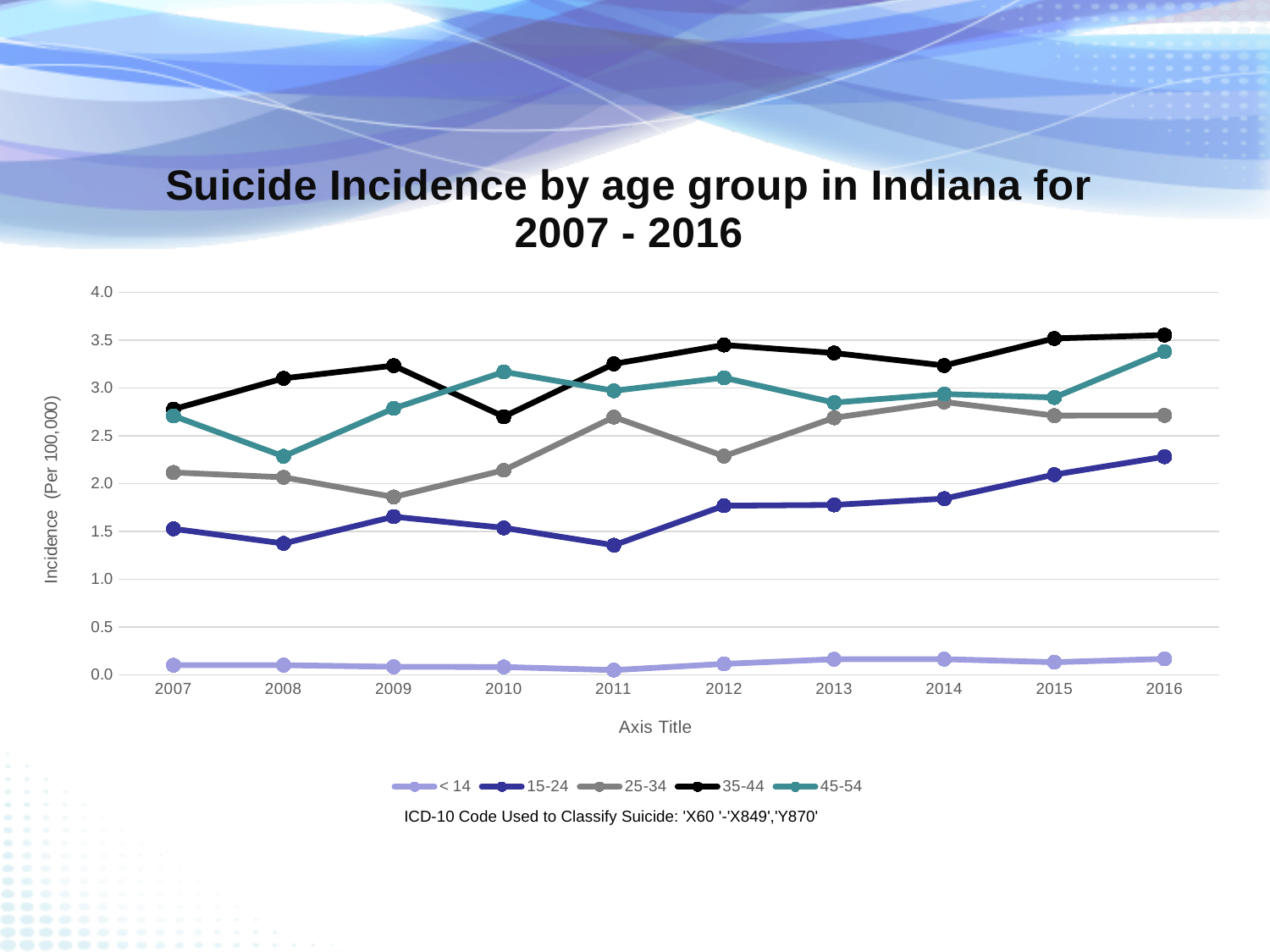
What is the label on the vertical axis? Incidence (Per 100,000) How many age-group series does the legend list? 5 Is the value for the 15-24 age group in 2011 greater or less than 1.5? less Which age group has the lowest values across all years shown? < 14 What is the title of the chart? Suicide Incidence by age group in Indiana for 2007 - 2016 Which age group has the highest value in 2016? 35-44 Is the value for the 25-34 age group in 2009 greater or less than 2.0? less What kind of chart is shown on the slide? line chart Is the value for the 35-44 age group in 2016 greater or less than 3.0? greater In 2010, which age group has the higher value: 45-54 or 35-44? 45-54 How many years are plotted along the x axis? 10